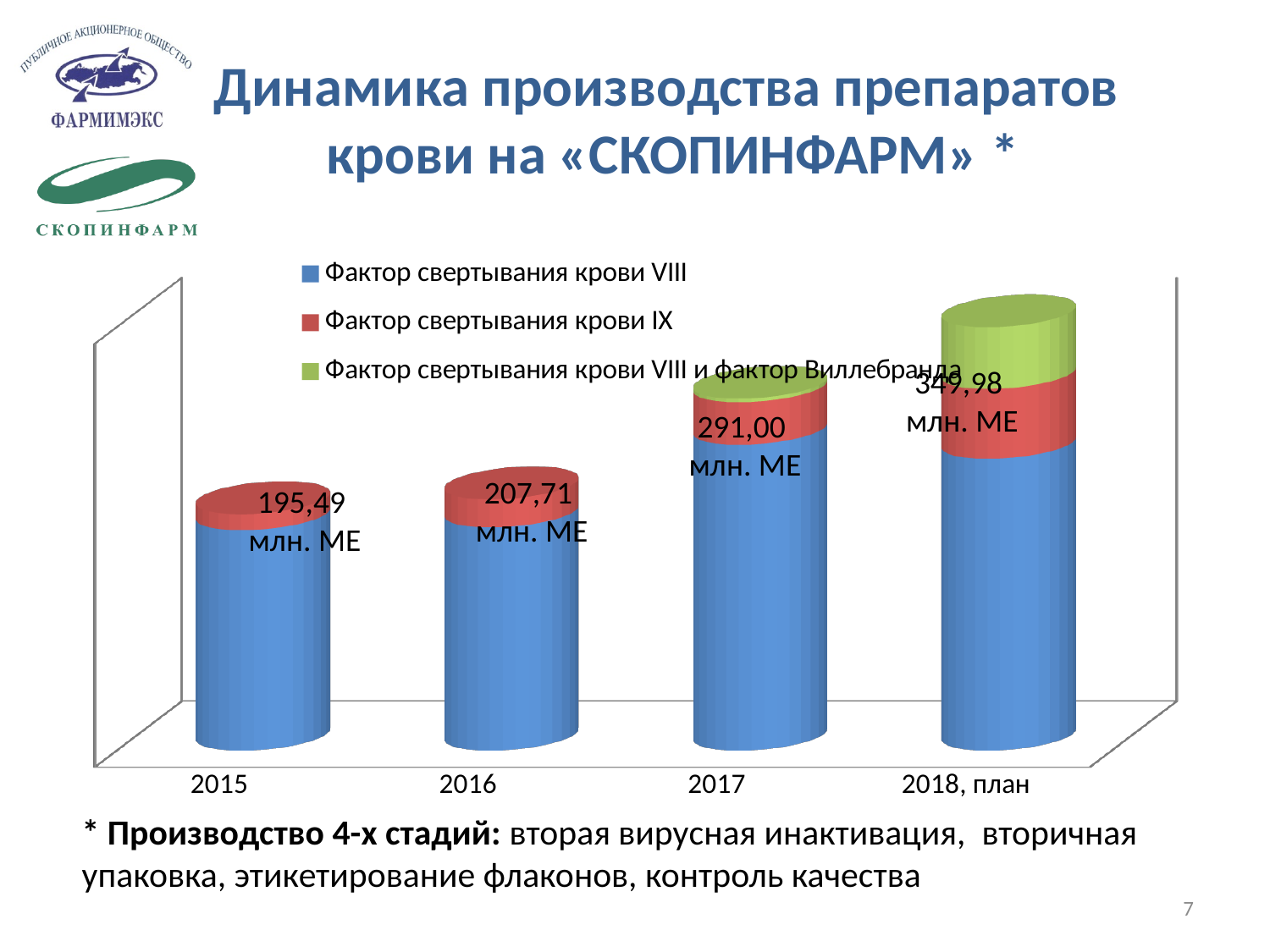
Do the labelled totals rise or fall from 2015 to 2018, план? Rise Which year has the lowest labelled total? 2015 What total value is labelled on the bar for 2015? 195,49 млн. МЕ What is the difference between the labelled totals for 2017 and 2016? 83,29 млн. МЕ What total value is labelled on the bar for 2018, план? 349,98 млн. МЕ What is the difference between the labelled totals for 2018, план and 2015? 154,49 млн. МЕ What total value is labelled on the bar for 2017? 291,00 млн. МЕ How many series does the legend list? 3 What kind of chart is shown on the slide? Stacked bar chart Which is larger, the labelled total for 2016 or for 2017? 2017 Which year has the highest labelled total? 2018, план How many categories are shown on the x axis? 4